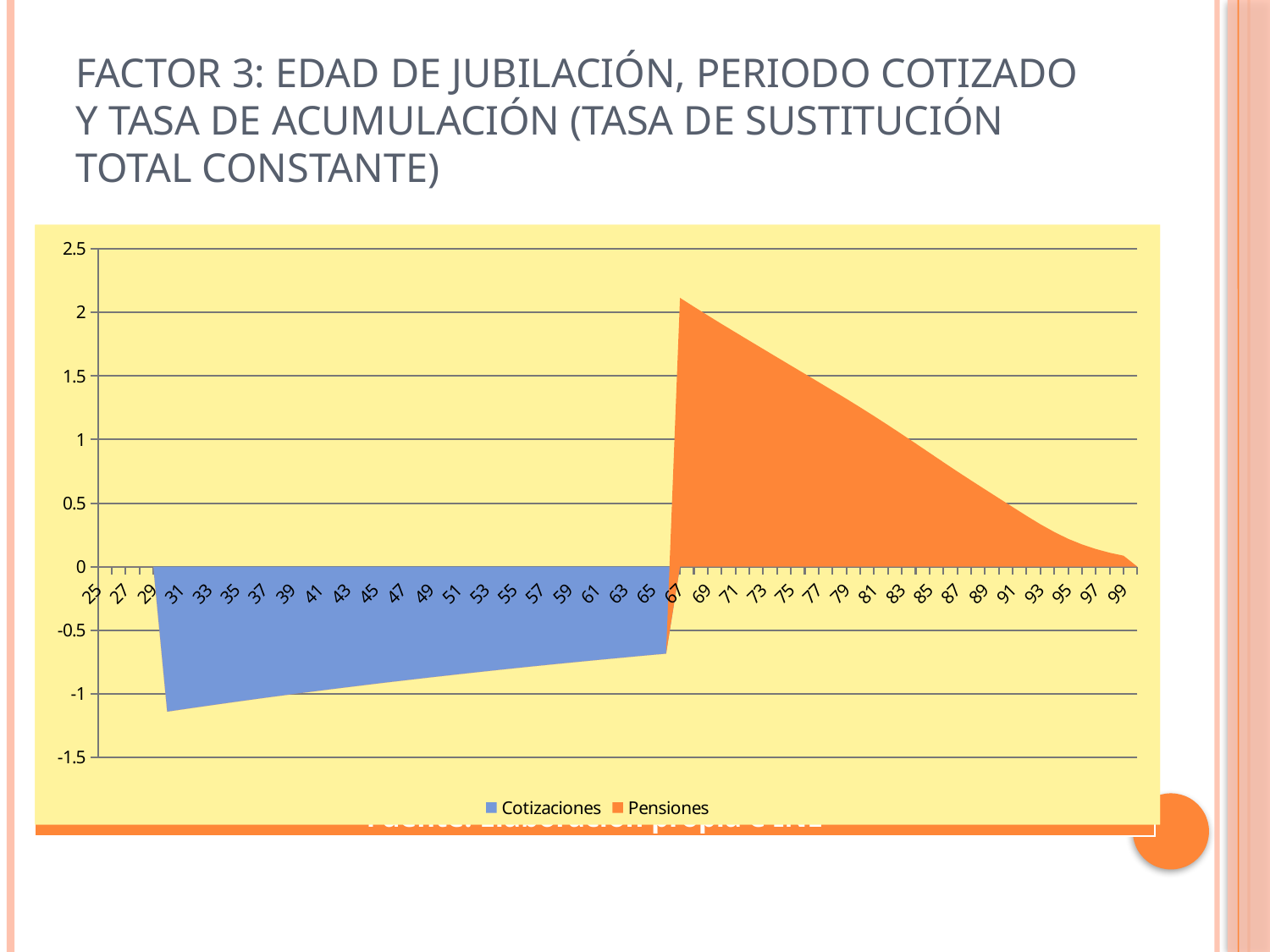
Is the value for Pensiones at age 95 greater or less than 0.5? less Which series has negative values on the chart? Cotizaciones How many series does the legend list? 2 Is the value for Pensiones at age 79 greater or less than 1? greater What is the highest value shown on the vertical axis? 2.5 Is the value for Cotizaciones at age 31 greater or less than -1? less Which colour represents the Pensiones series? Orange Do the Pensiones values rise or fall as age increases from 67 to 99? Fall What are the two series named in the legend? Cotizaciones and Pensiones What kind of chart is shown on the slide? Area chart